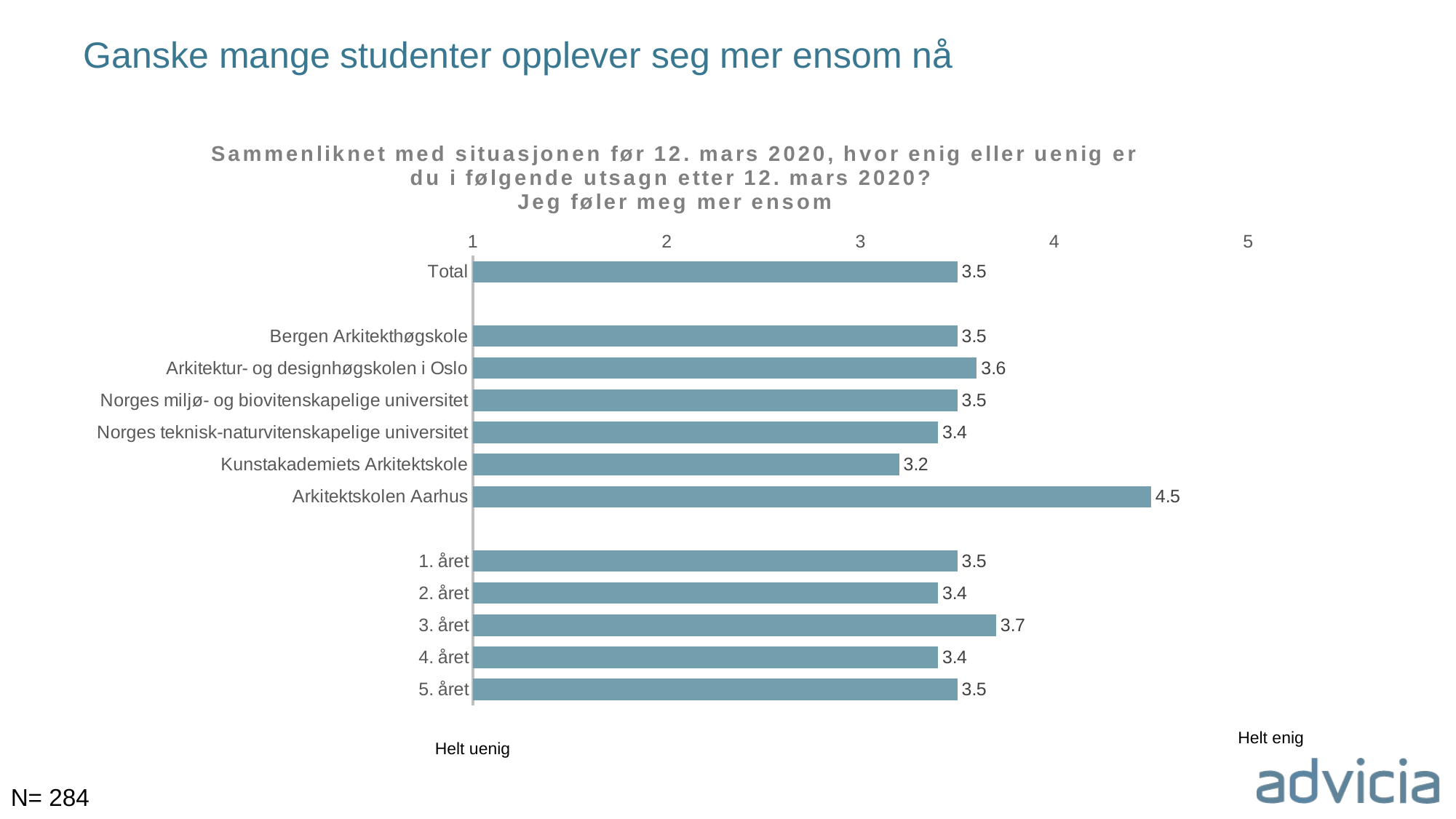
What is the difference between the values for Arkitektskolen Aarhus and Kunstakademiets Arkitektskole? 1.3 What is the value for Total? 3.5 What is the value for Kunstakademiets Arkitektskole? 3.2 What is the value for 3. året? 3.7 Which category has the highest value? Arkitektskolen Aarhus What kind of chart is shown on the slide? bar chart How many bars are plotted on the chart? 12 Which category has the lowest value? Kunstakademiets Arkitektskole What is the value for Arkitektskolen Aarhus? 4.5 What label appears at the right end of the axis, under the value 5? Helt enig Is the value for Arkitektskolen Aarhus greater or less than 4? greater Which is larger, the value for 3. året or the value for 2. året? 3. året